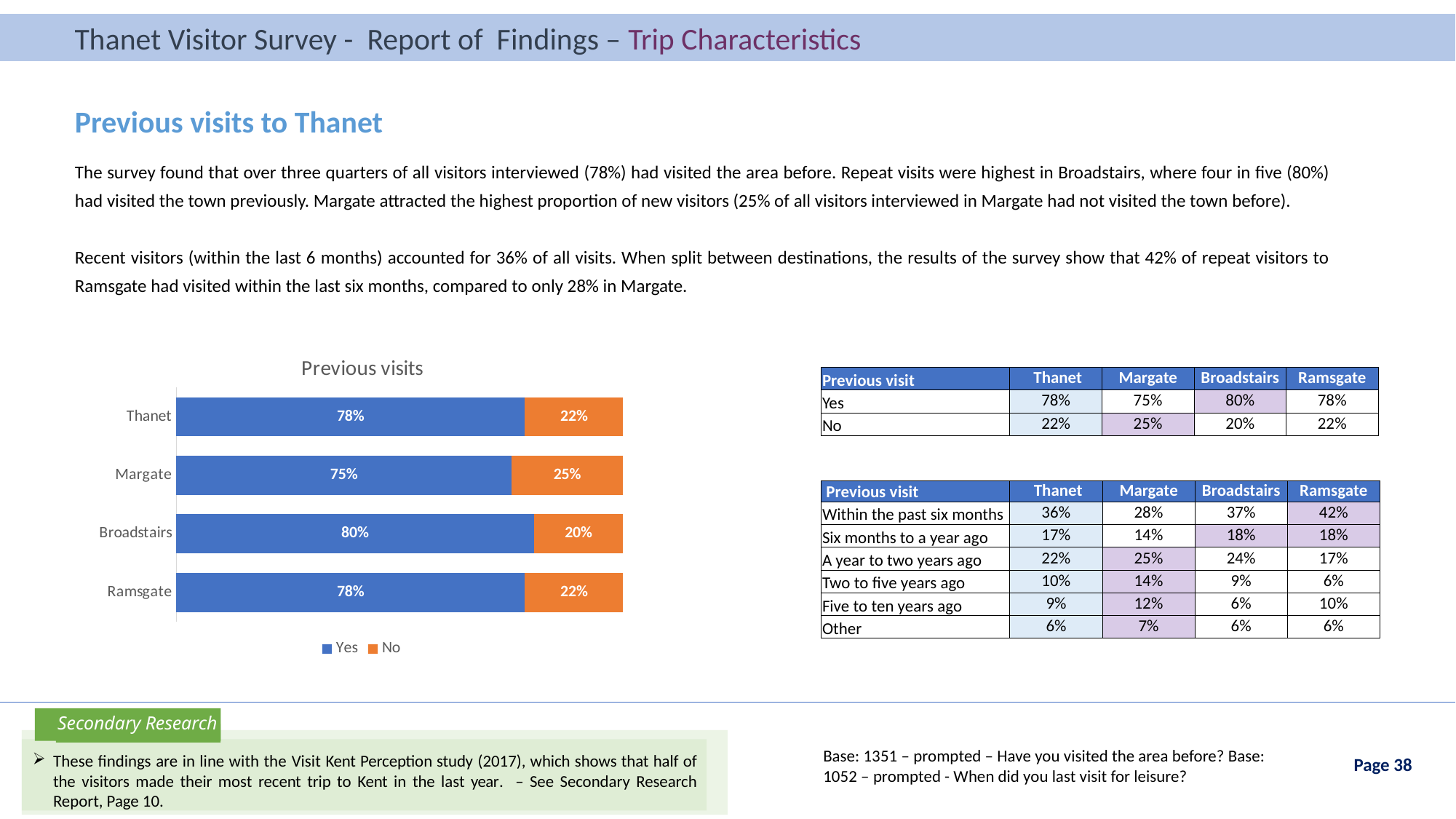
In the 'Previous visits' chart, what is the 'Yes' value for Broadstairs? 80% In the 'Previous visits' chart, what is the difference between the 'Yes' values for Broadstairs and Margate? 5% What type of chart is the 'Previous visits' chart? Stacked bar chart In the 'Previous visits' chart, what is the 'No' value for Margate? 25% In the 'Previous visits' chart, which is larger: the 'No' value for Margate or the 'No' value for Broadstairs? Margate In the 'Previous visits' chart, what is the total of the stacked bar for Thanet? 100% How many series does the legend of the 'Previous visits' chart list? 2 In the 'Previous visits' chart, which colour represents the 'No' series? Orange In the 'Previous visits' chart, what is the 'Yes' value for Ramsgate? 78% In the 'Previous visits' chart, which destination has the highest 'Yes' value? Broadstairs In the 'Previous visits' chart, which destination has the lowest 'Yes' value? Margate How many destinations are shown in the 'Previous visits' chart? 4